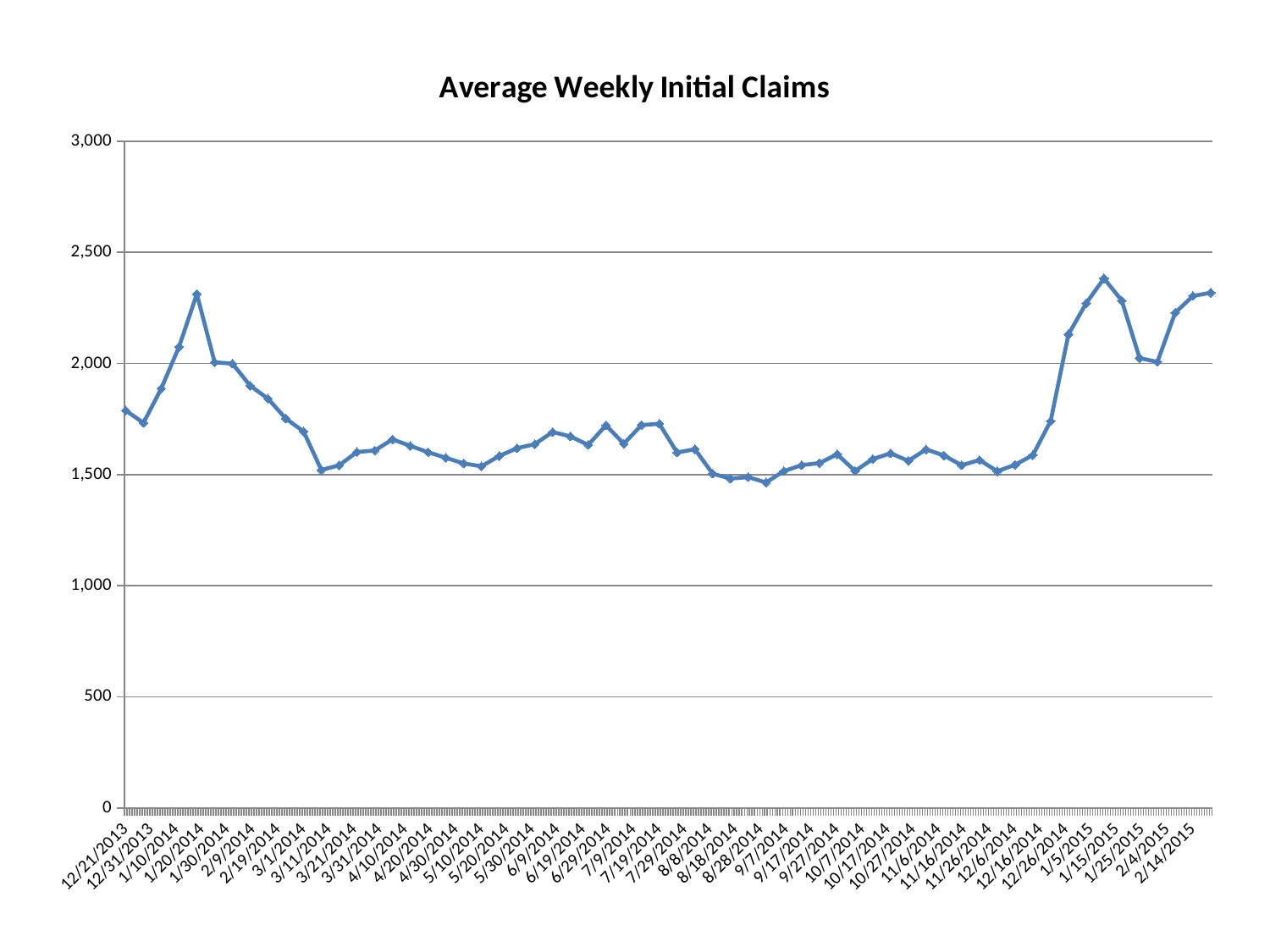
Is the value for 12/21/2013 greater or less than 1,500? greater Which is higher, the peak in January 2014 or the peak in January 2015? January 2015 Is the lowest value on the chart greater or less than 2,000? less Is the value at the last point on the chart greater or less than 2,000? greater What is the title of the chart? Average Weekly Initial Claims What kind of chart is shown on the slide? line chart Do the values rise or fall between the late January 2014 peak and 3/11/2014? fall Do the values rise or fall between 12/6/2014 and mid-January 2015? rise What is the highest value shown on the vertical axis? 3,000